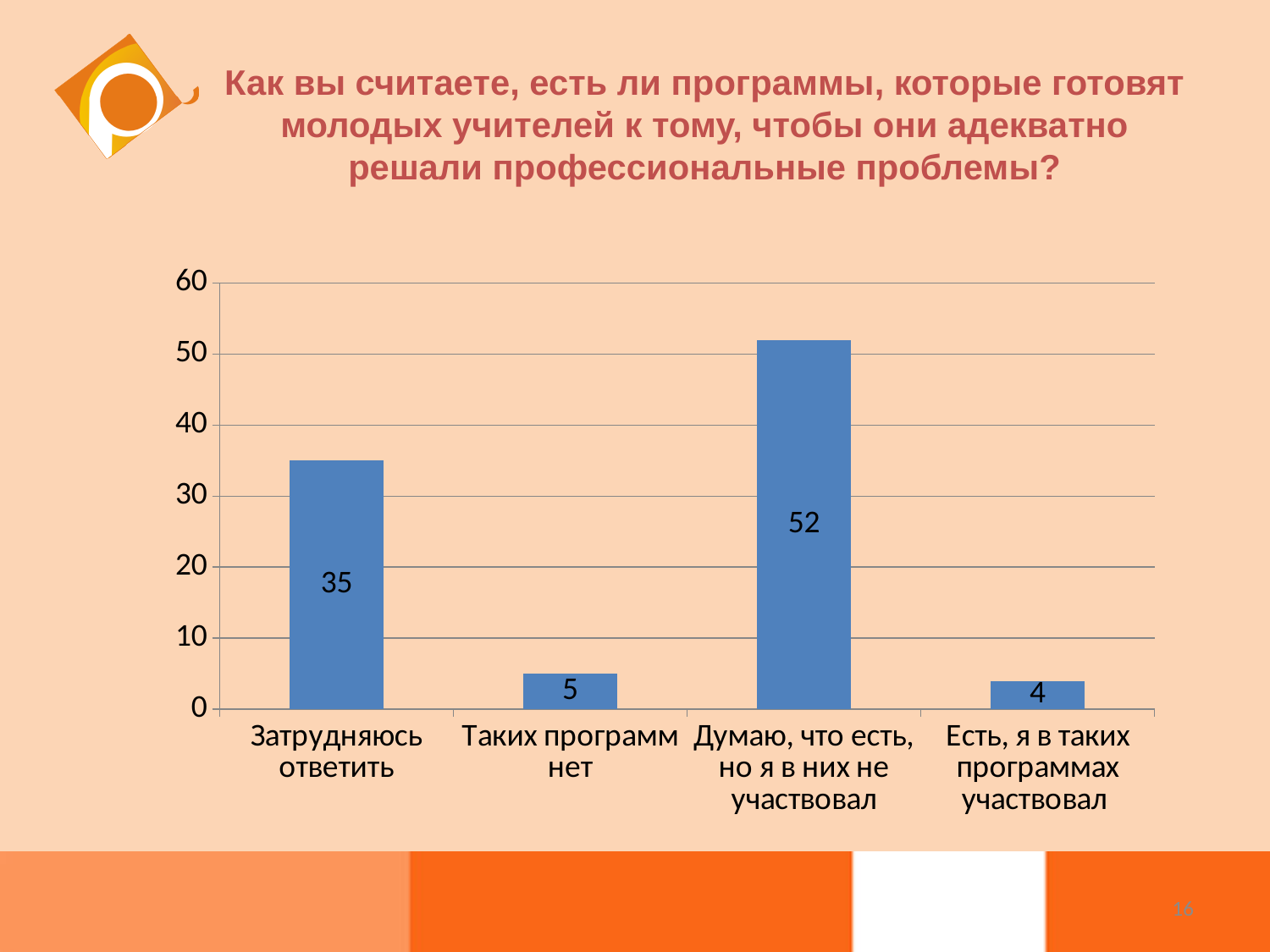
Is the value for "Думаю, что есть, но я в них не участвовал" greater or less than 50? greater Which category has the highest value? Думаю, что есть, но я в них не участвовал What is the value for "Затрудняюсь ответить"? 35 What is the value for "Думаю, что есть, но я в них не участвовал"? 52 Which category has the lowest value? Есть, я в таких программах участвовал Which is larger: the value for "Затрудняюсь ответить" or the value for "Таких программ нет"? Затрудняюсь ответить What is the value for "Есть, я в таких программах участвовал"? 4 How many categories are shown on the x axis? 4 What is the value for "Таких программ нет"? 5 What kind of chart is shown on the slide? bar chart What is the highest value shown on the vertical axis? 60 What is the difference between the values for "Думаю, что есть, но я в них не участвовал" and "Затрудняюсь ответить"? 17